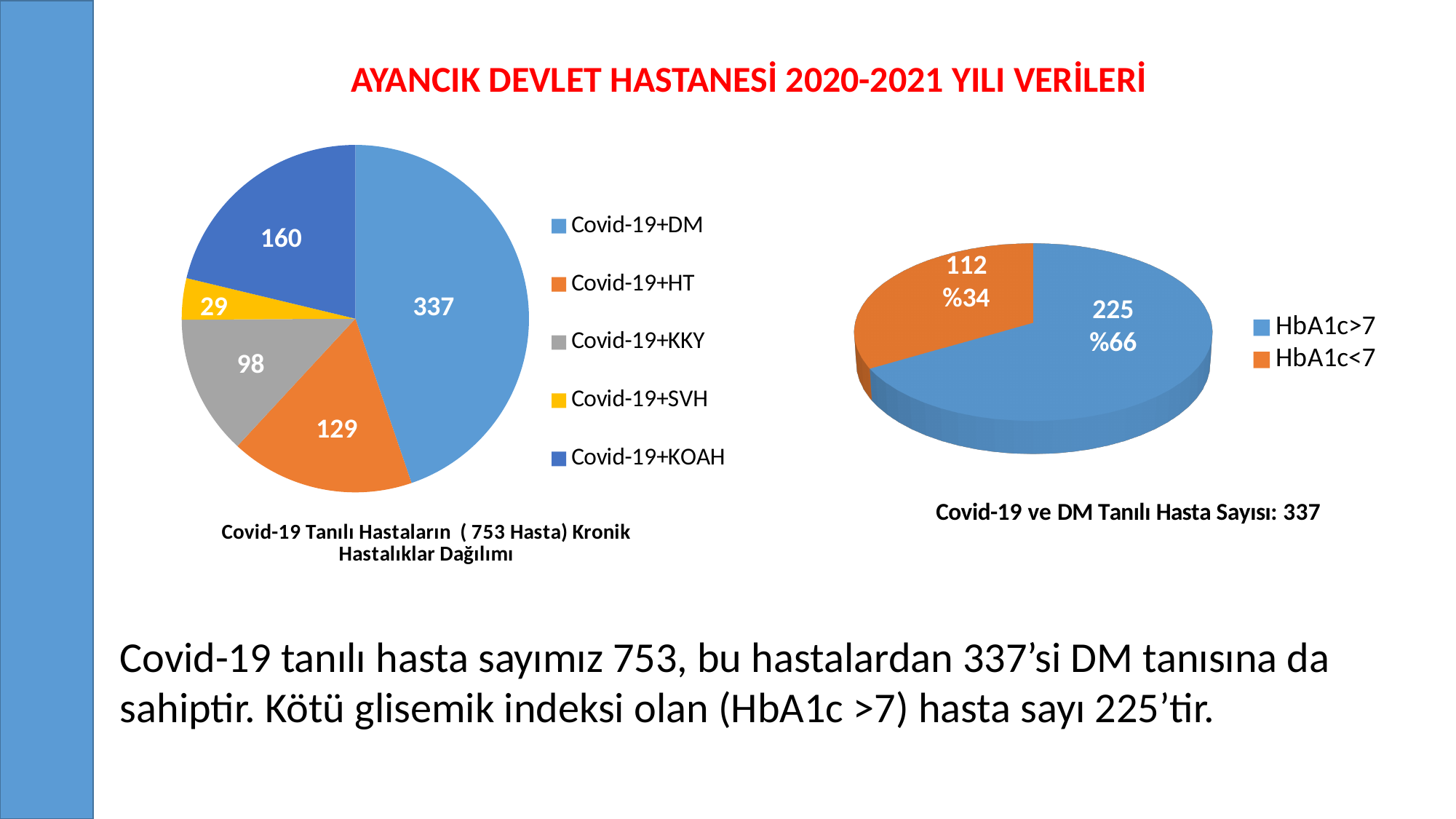
On the left chart, what colour is the Covid-19+SVH slice? Yellow On the left chart, what is the difference between the values for Covid-19+HT and Covid-19+KKY? 31 On the left chart, which is larger: Covid-19+KOAH or Covid-19+HT? Covid-19+KOAH On the right chart, what is the difference between the HbA1c>7 and HbA1c<7 values? 113 On the right chart, what share of the pie is HbA1c<7? %34 On the right chart (Covid-19 ve DM Tanılı Hasta Sayısı: 337), what is the value for HbA1c>7? 225 On the left chart, what is the value for Covid-19+KOAH? 160 On the left chart, which category has the largest slice? Covid-19+DM What kind of chart is the left chart? Pie chart How many categories does the left chart's legend list? 5 On the left chart, which category has the smallest slice? Covid-19+SVH On the left chart (Covid-19 Tanılı Hastaların Kronik Hastalıklar Dağılımı), what is the value for Covid-19+DM? 337